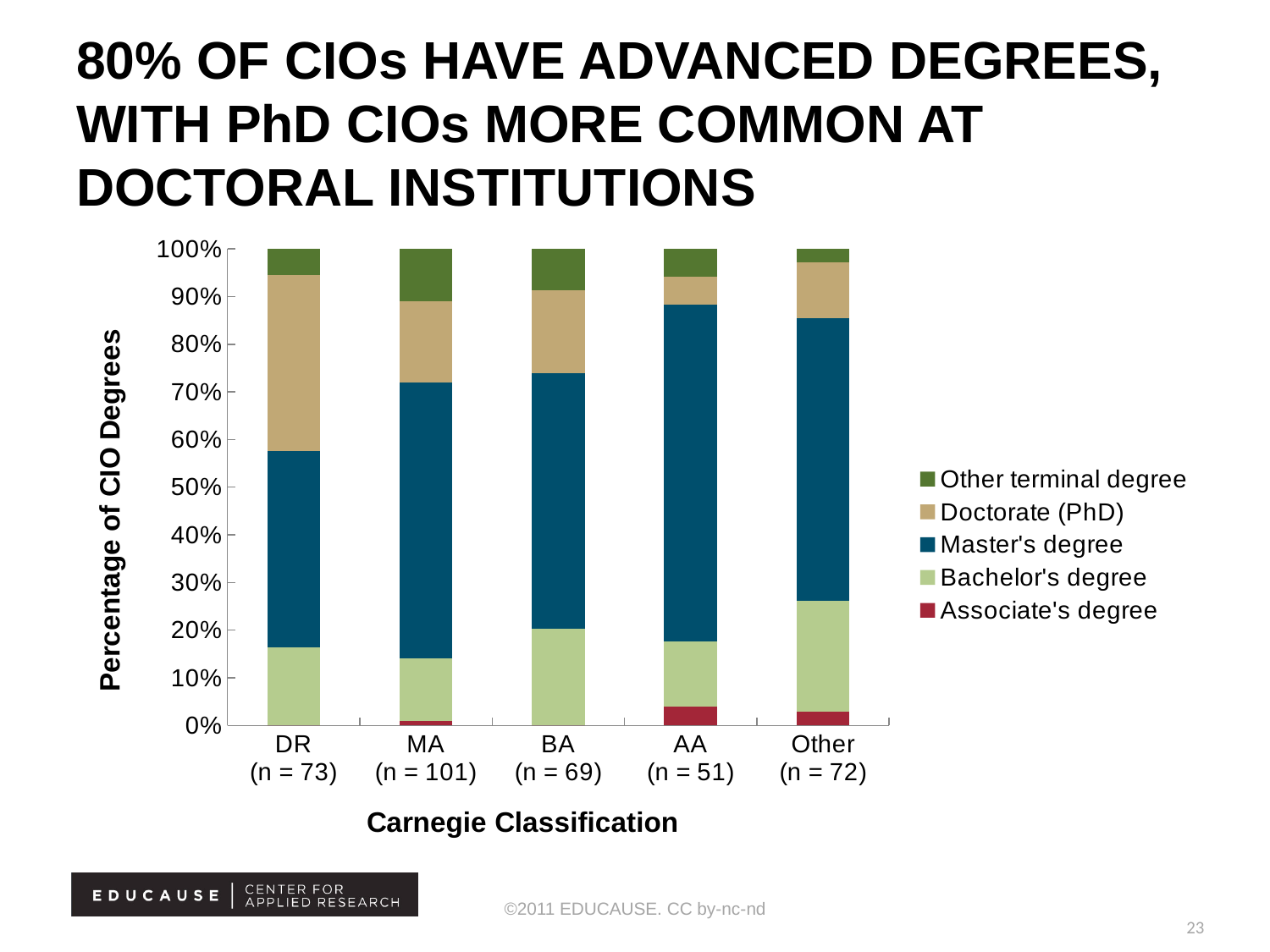
What kind of chart is shown on the slide? Stacked bar chart Which Carnegie Classification has the largest Doctorate (PhD) share? DR Is the Bachelor's degree share larger for Other or for MA? Other Is the Bachelor's degree share for BA greater or less than 10%? greater Which Carnegie Classification has the smallest Doctorate (PhD) share? AA How many series does the legend list? 5 Which Carnegie Classification has the largest Master's degree share? AA Is the Other terminal degree share larger for MA or for Other? MA Is the Master's degree share for AA greater or less than 60%? greater What is the title of the y axis? Percentage of CIO Degrees How many bars include an Associate's degree segment? 3 How many Carnegie Classification categories are plotted on the x axis? 5